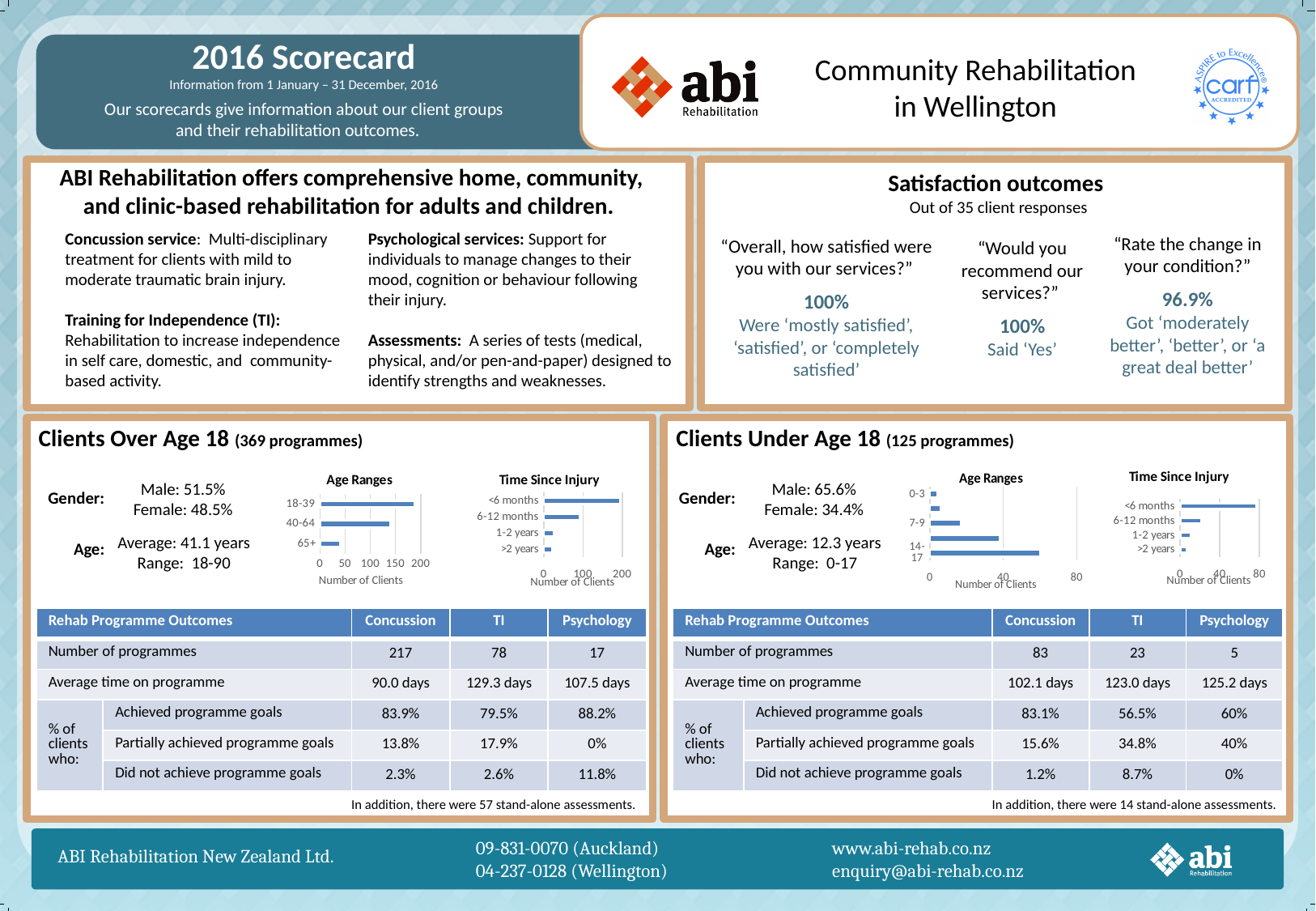
In the Age Ranges chart for Clients Over Age 18, is the value for 18-39 greater or less than 150? greater In the Age Ranges chart for Clients Over Age 18, which age range has the highest number of clients? 18-39 How many age ranges are shown in the Age Ranges chart for Clients Over Age 18? 3 In the Time Since Injury chart for Clients Under Age 18, is the value for <6 months greater or less than 40? greater In the Time Since Injury chart for Clients Over Age 18, which category has the highest number of clients? <6 months In the Age Ranges chart for Clients Under Age 18, which age range has the highest number of clients? 14-17 What is the x-axis label of the Time Since Injury chart for Clients Under Age 18? Number of Clients What kind of chart is the Age Ranges chart in the Clients Over Age 18 section? bar chart In the Age Ranges chart for Clients Over Age 18, which age range has the lowest number of clients? 65+ In the Age Ranges chart for Clients Over Age 18, is the value for 65+ greater or less than 50? less How many categories are shown in the Time Since Injury chart for Clients Under Age 18? 4